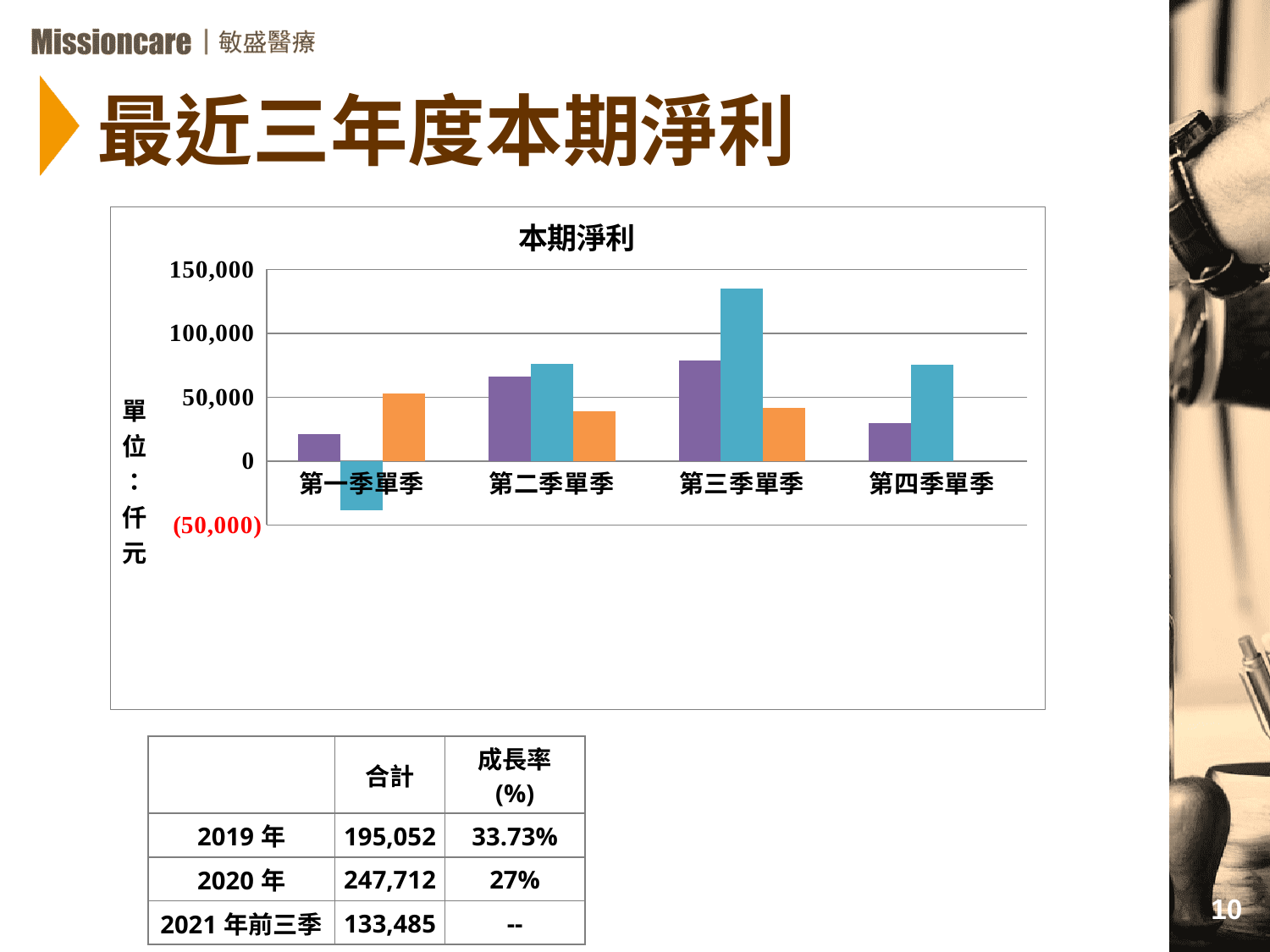
In which quarter is the blue bar the lowest? 第一季單季 What unit is stated for the values in the chart? 仟元 Is the purple bar for 第一季單季 greater or less than 50,000? less Is the blue bar for 第三季單季 greater or less than 100,000? greater Is the blue bar for 第四季單季 greater or less than 50,000? greater How many bars are plotted for the 第二季單季 category? 3 For 第三季單季, which is larger, the purple bar or the blue bar? the blue bar What is the title of the chart? 本期淨利 How many quarter categories are shown on the x axis of the chart? 4 Which quarter has the tallest bar in the chart? 第三季單季 What kind of chart is shown on the slide? bar chart